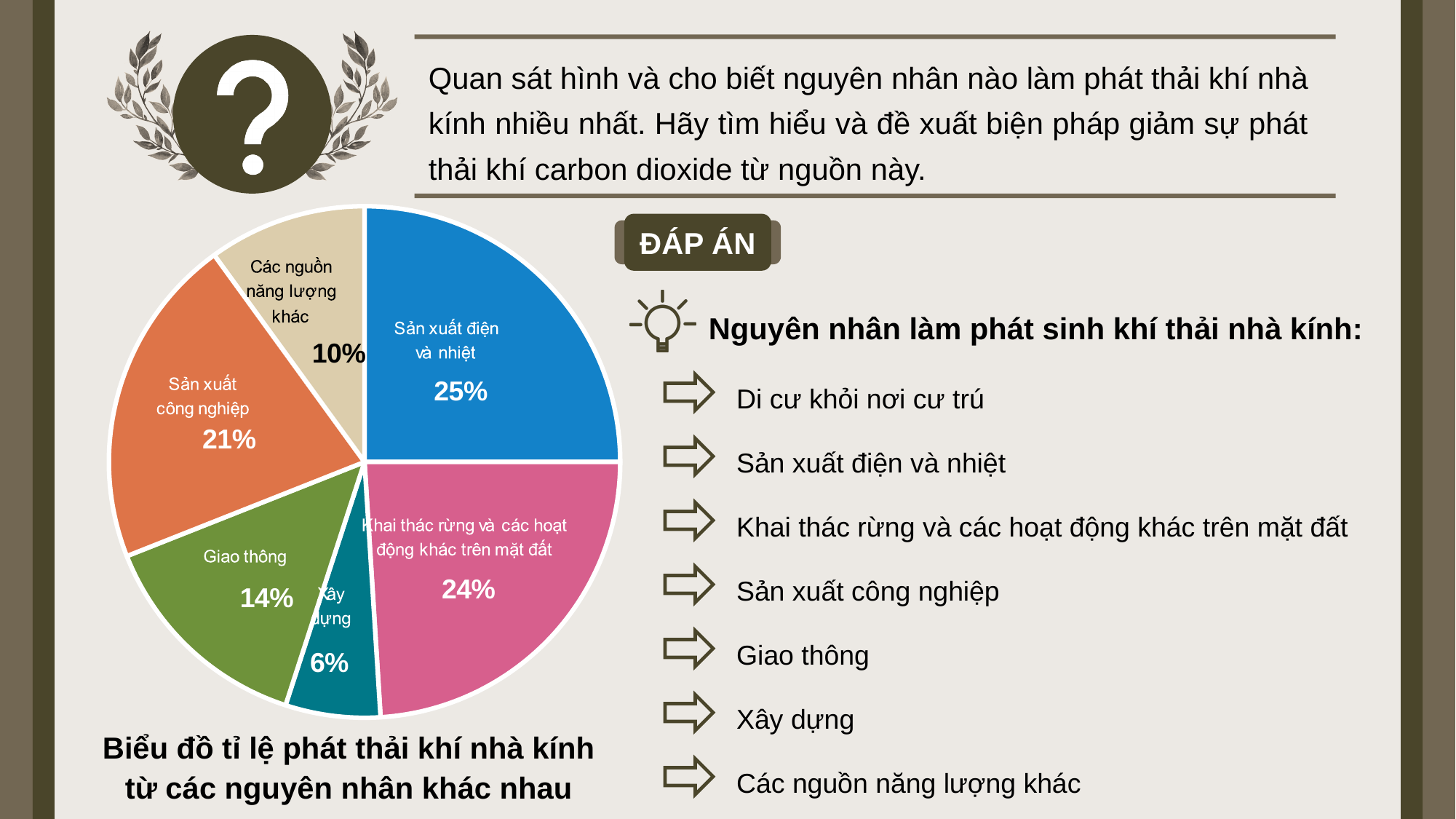
How many slices does the pie chart have? 6 What percentage does the pie chart show for Sản xuất điện và nhiệt? 25% What percentage does the pie chart show for Sản xuất công nghiệp? 21% What percentage does the pie chart show for Giao thông? 14% What type of chart is shown on the slide? Pie chart What is the combined share of Giao thông and Xây dựng in the pie chart? 20% Which category has the largest slice in the pie chart? Sản xuất điện và nhiệt What is the title of the chart on the slide? Biểu đồ tỉ lệ phát thải khí nhà kính từ các nguyên nhân khác nhau What is the difference in percentage points between Sản xuất công nghiệp and Giao thông? 7 Which category has the smallest slice in the pie chart? Xây dựng What percentage does the pie chart show for Xây dựng? 6% Which is larger in the pie chart: Khai thác rừng và các hoạt động khác trên mặt đất or Sản xuất công nghiệp? Khai thác rừng và các hoạt động khác trên mặt đất